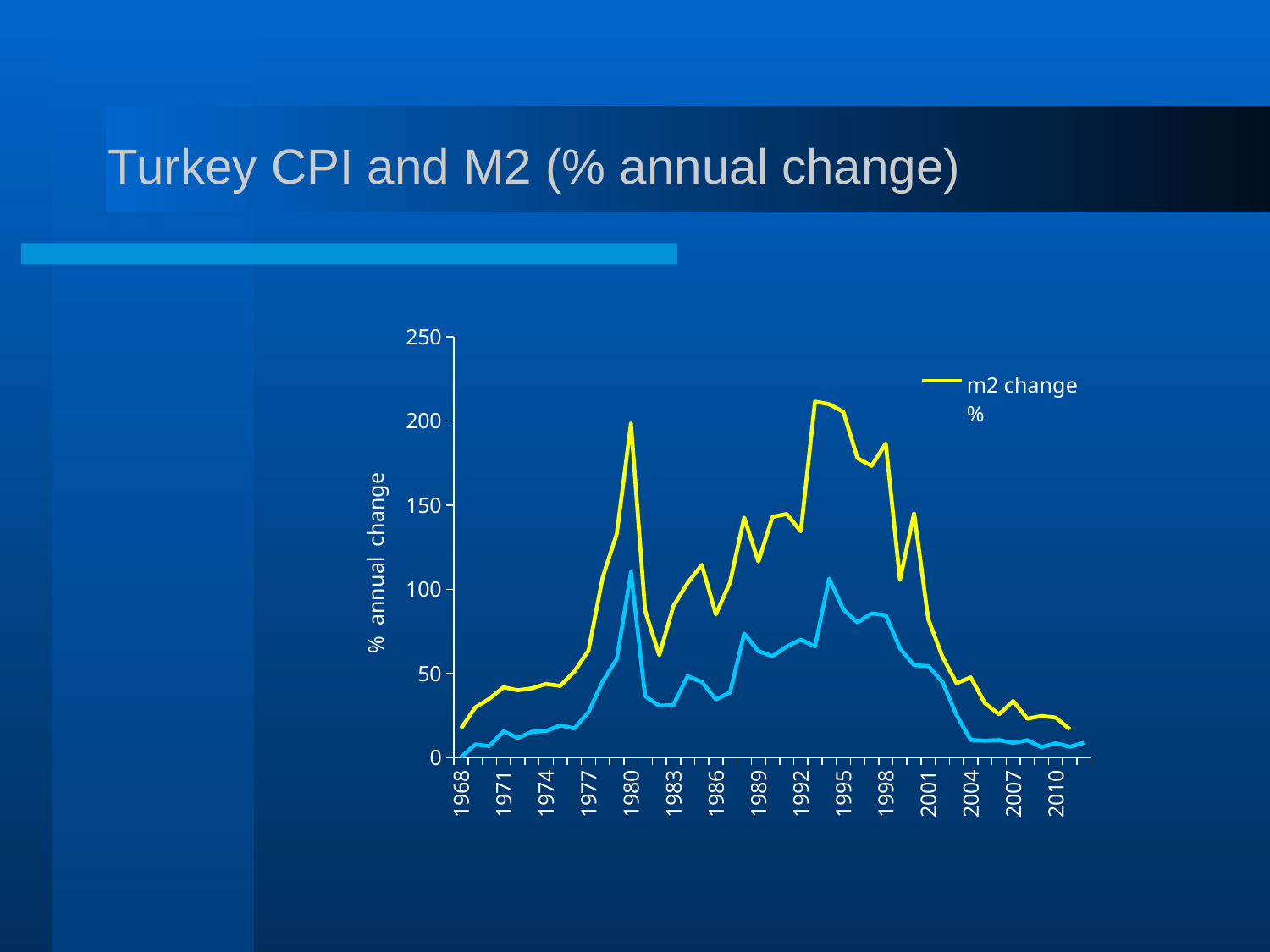
Does m2 change % rise or fall between 1998 and 2010? fall Is the value for m2 change % in 2004 greater or less than 100? less Is the value for m2 change % in 2010 greater or less than 50? less Is the value for m2 change % in 1968 greater or less than 50? less What is the label on the vertical axis of the chart? % annual change What kind of chart is shown on the slide? line chart What is the title of the slide's chart? Turkey CPI and M2 (% annual change) How many series does the chart's legend list? 1